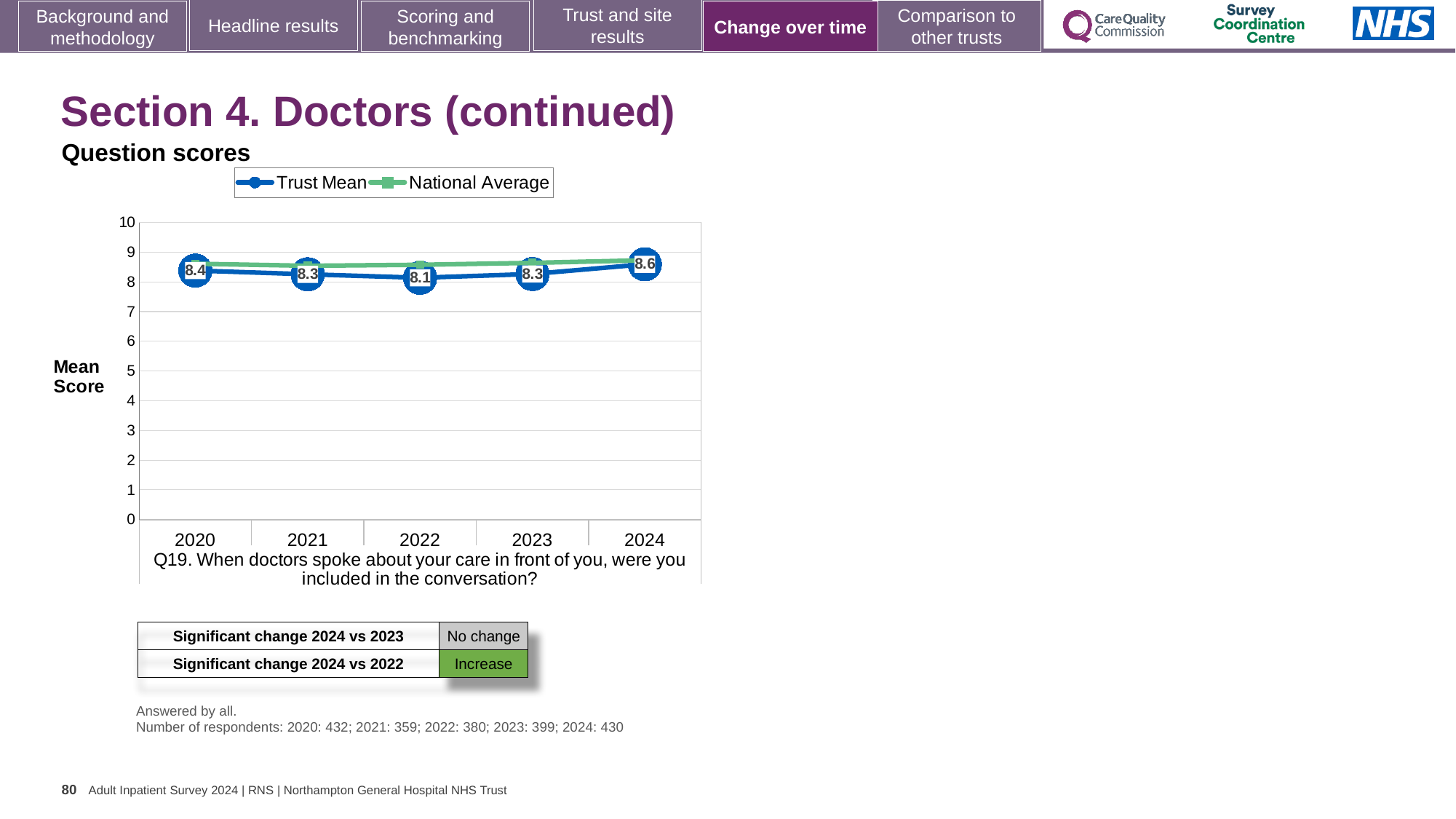
Is the National Average value for 2024 greater or less than 8? greater What is the Trust Mean score for 2022? 8.1 How many years are shown on the x axis of the chart? 5 What is the difference between the Trust Mean score in 2024 and in 2022? 0.5 How many series does the chart legend list? 2 Does the Trust Mean score rise or fall from 2022 to 2024? rise What is the Trust Mean score for 2024? 8.6 What is the Trust Mean score for 2020? 8.4 What kind of chart is shown on the slide? line chart In which year is the Trust Mean score lowest? 2022 In which year is the Trust Mean score highest? 2024 Which is larger, the Trust Mean score for 2020 or for 2021? 2020